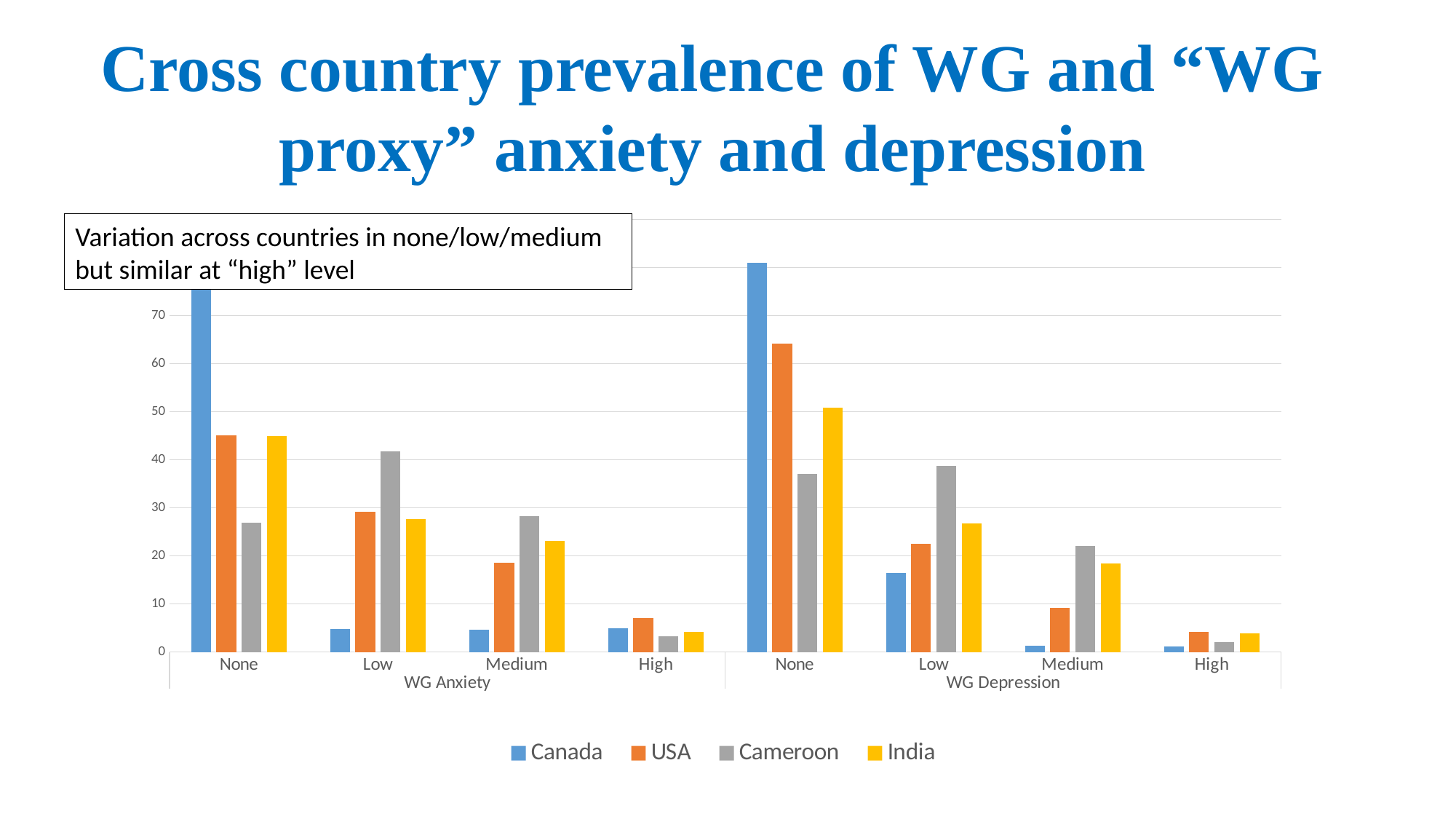
Which country has the lowest value for Medium under WG Depression? Canada For Low under WG Depression, which is larger: the value for USA or the value for India? India Do the values for Canada rise or fall from None to High under WG Depression? fall How many severity levels are shown within each of the WG Anxiety and WG Depression groups? 4 Which countries are listed in the legend? Canada, USA, Cameroon, India Is the value for Canada at Low under WG Anxiety greater or less than 10? less Is the value for USA at None under WG Depression greater or less than 60? greater What kind of chart is shown on the slide? bar chart Which country has the highest value for None under WG Depression? Canada Is the value for Cameroon at Low under WG Anxiety greater or less than 30? greater How many series does the legend list? 4 Which country has the highest value for Low under WG Anxiety? Cameroon